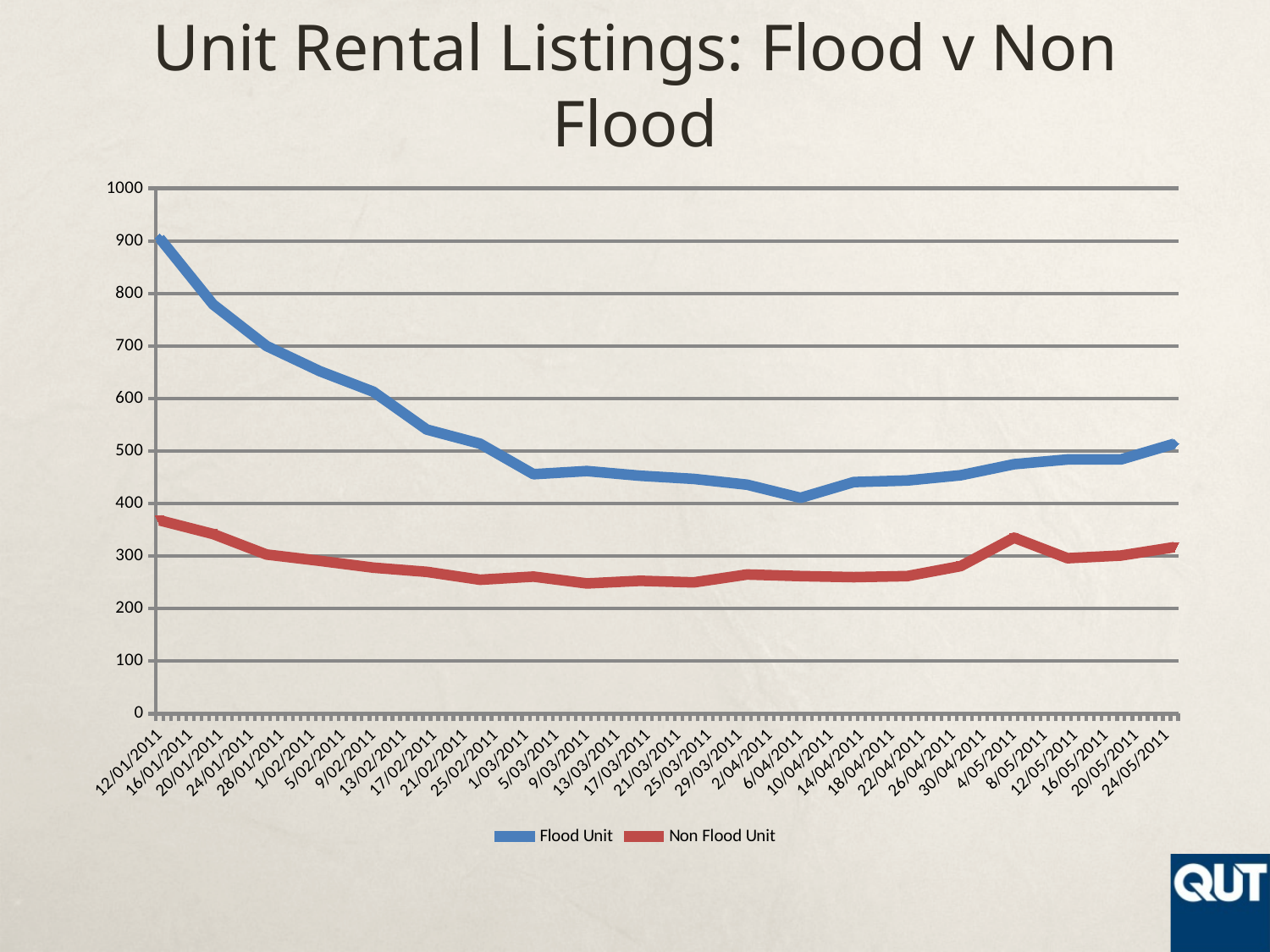
Is the Non Flood Unit value on 12/01/2011 greater or less than 300? greater Is the Non Flood Unit value on 4/05/2011 greater or less than 300? greater On 12/01/2011, which series has the higher value, Flood Unit or Non Flood Unit? Flood Unit Is the Non Flood Unit value on 9/03/2011 greater or less than 300? less On which date does the Flood Unit series reach its highest value? 12/01/2011 How many series does the legend list? 2 What are the two series named in the legend? Flood Unit and Non Flood Unit What kind of chart is shown on the slide? line chart Does the Flood Unit line rise or fall between 12/01/2011 and 6/04/2011? fall What is the title of the chart? Unit Rental Listings: Flood v Non Flood